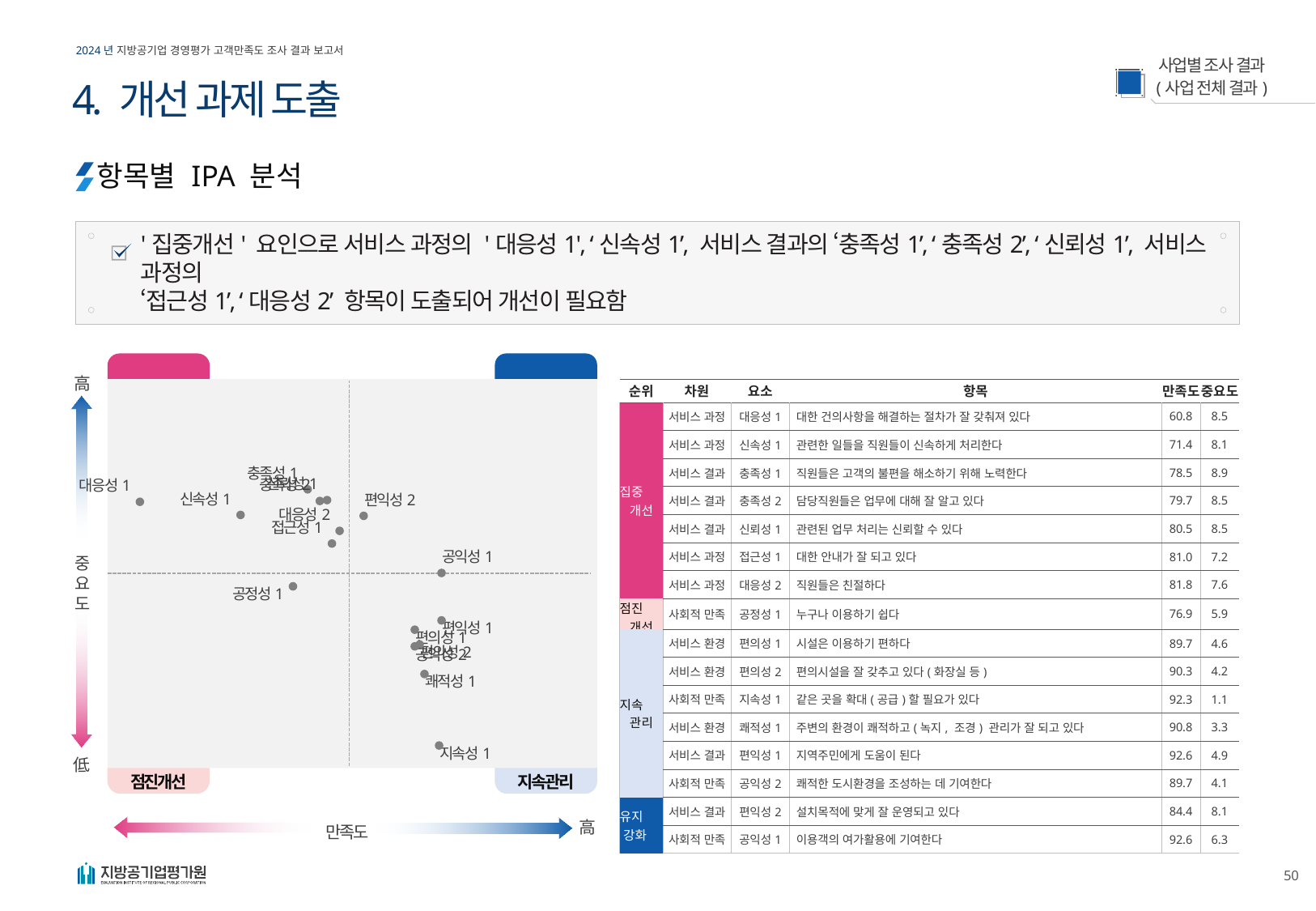
In the IPA chart, how many points are plotted in the bottom-left (점진개선) quadrant? 1 What does the vertical axis of the IPA chart represent? 중요도 What does the horizontal axis of the IPA chart represent? 만족도 In the IPA chart, which has higher importance, 신속성 1 or 공정성 1? 신속성 1 In the IPA chart, which point has the lowest satisfaction (furthest left)? 대응성 1 In the IPA chart, which has higher satisfaction, 대응성 1 or 지속성 1? 지속성 1 What kind of chart is shown on the left of the slide? scatter chart In the IPA chart, which point has the lowest importance (lowest on the chart)? 지속성 1 In the IPA chart, which has higher satisfaction, 공정성 1 or 쾌적성 1? 쾌적성 1 In the IPA chart, which quadrant is 공정성 1 plotted in? 점진개선